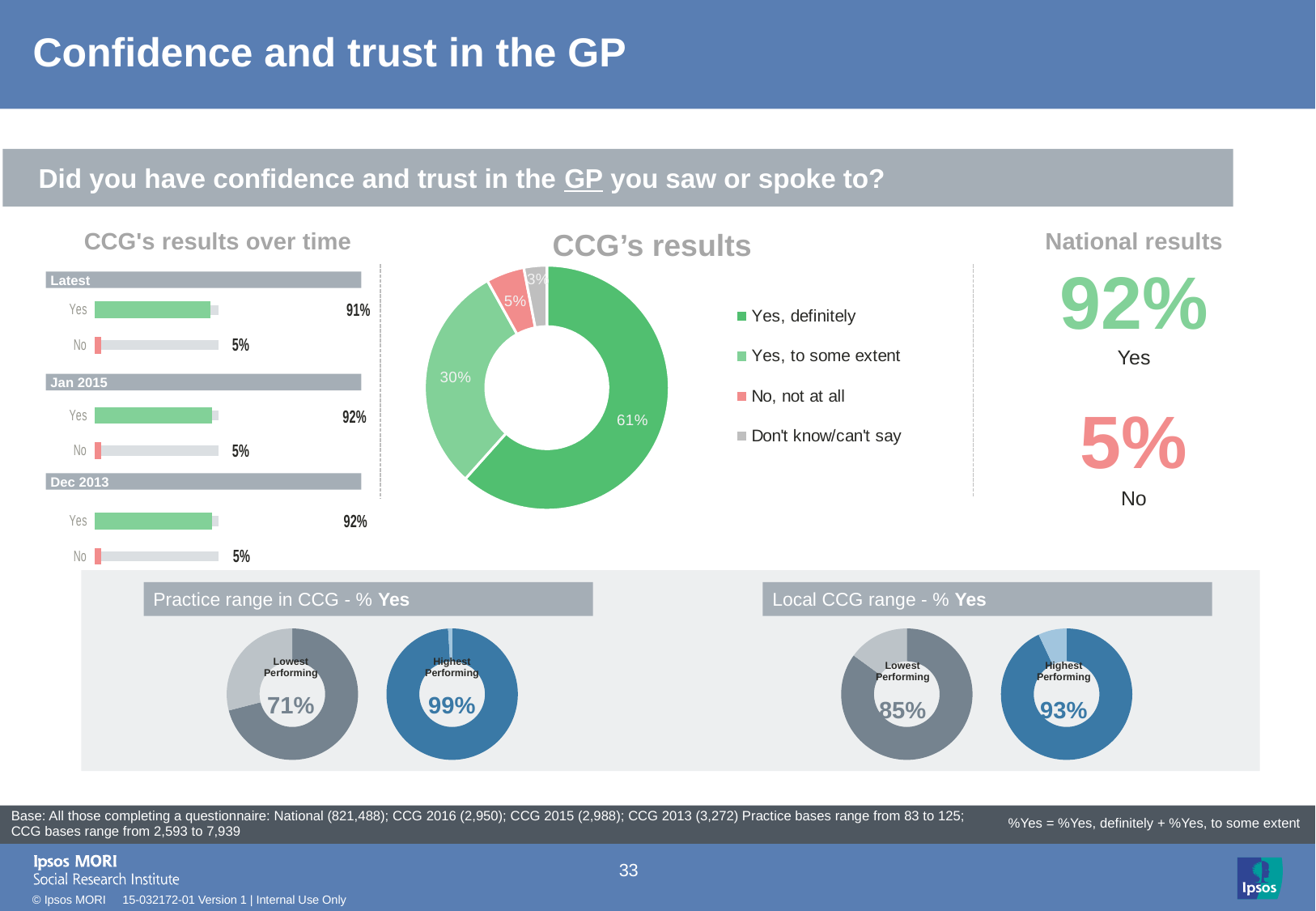
In the "CCG's results" donut chart, what percentage answered "Yes, to some extent"? 30% In the "Practice range in CCG - % Yes" section, what is the difference between the Highest Performing and Lowest Performing values? 28 percentage points In the "CCG's results" donut chart, which response category has the smallest share? Don't know/can't say In the "Practice range in CCG - % Yes" section, what is the Highest Performing value? 99% In the "CCG's results over time" chart, what is the Yes value for Jan 2015? 92% In the "CCG's results over time" chart, what kind of chart is used to show the Yes and No values? Bar chart In the "CCG's results over time" chart, what is the Yes value for Latest? 91% In the "CCG's results" donut chart, which response category has the largest share? Yes, definitely In the "CCG's results" donut chart, what percentage answered "Yes, definitely"? 61% In the "CCG's results" donut chart, how many response categories does the legend list? 4 In the "Local CCG range - % Yes" section, what is the Lowest Performing value? 85% In the "CCG's results" donut chart, what is the difference between the "Yes, definitely" and "Yes, to some extent" shares? 31 percentage points